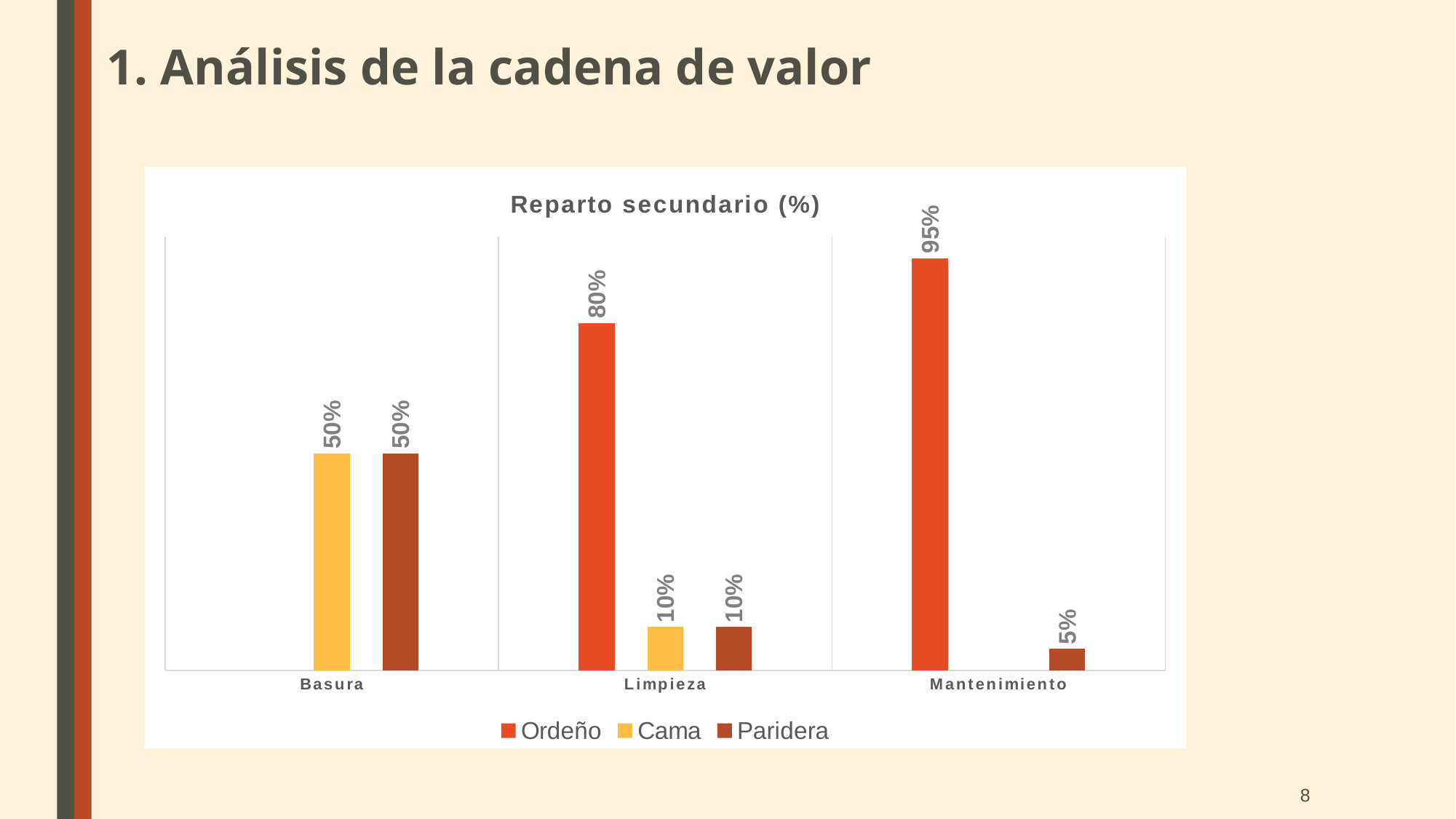
In which category does Paridera have its lowest value? Mantenimiento What is the value for Ordeño in the Mantenimiento category? 95% What is the difference between the Ordeño and Cama values in the Limpieza category? 70% How many categories are shown on the x axis? 3 In which category does Ordeño have its highest value? Mantenimiento How many series does the legend list? 3 Which is larger in the Limpieza category: Ordeño or Paridera? Ordeño What is the value for Ordeño in the Limpieza category? 80% What is the title of the chart? Reparto secundario (%) What is the value for Cama in the Basura category? 50% What kind of chart is shown on the slide? Bar chart What is the value for Paridera in the Mantenimiento category? 5%